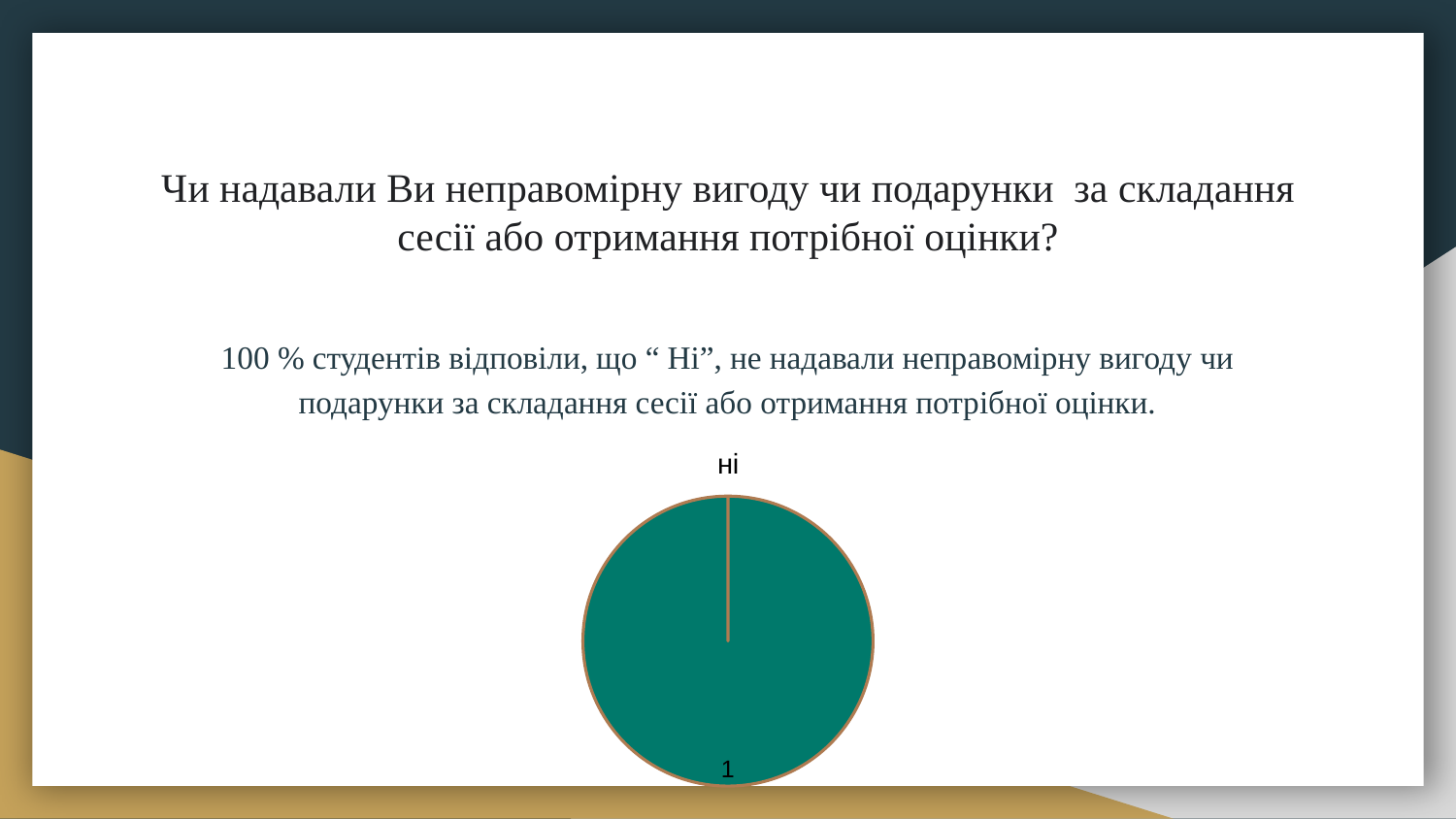
Which category is the largest slice of the pie chart? 1 What kind of chart is shown on the slide? pie chart What is the title of the pie chart? ні What is the data label shown on the pie slice? 1 What colour is the pie slice? teal green How many slices does the pie chart have? 1 What share of the pie does the "ні" slice take up? 100% According to the slide text, what percentage of students answered "Ні"? 100 %